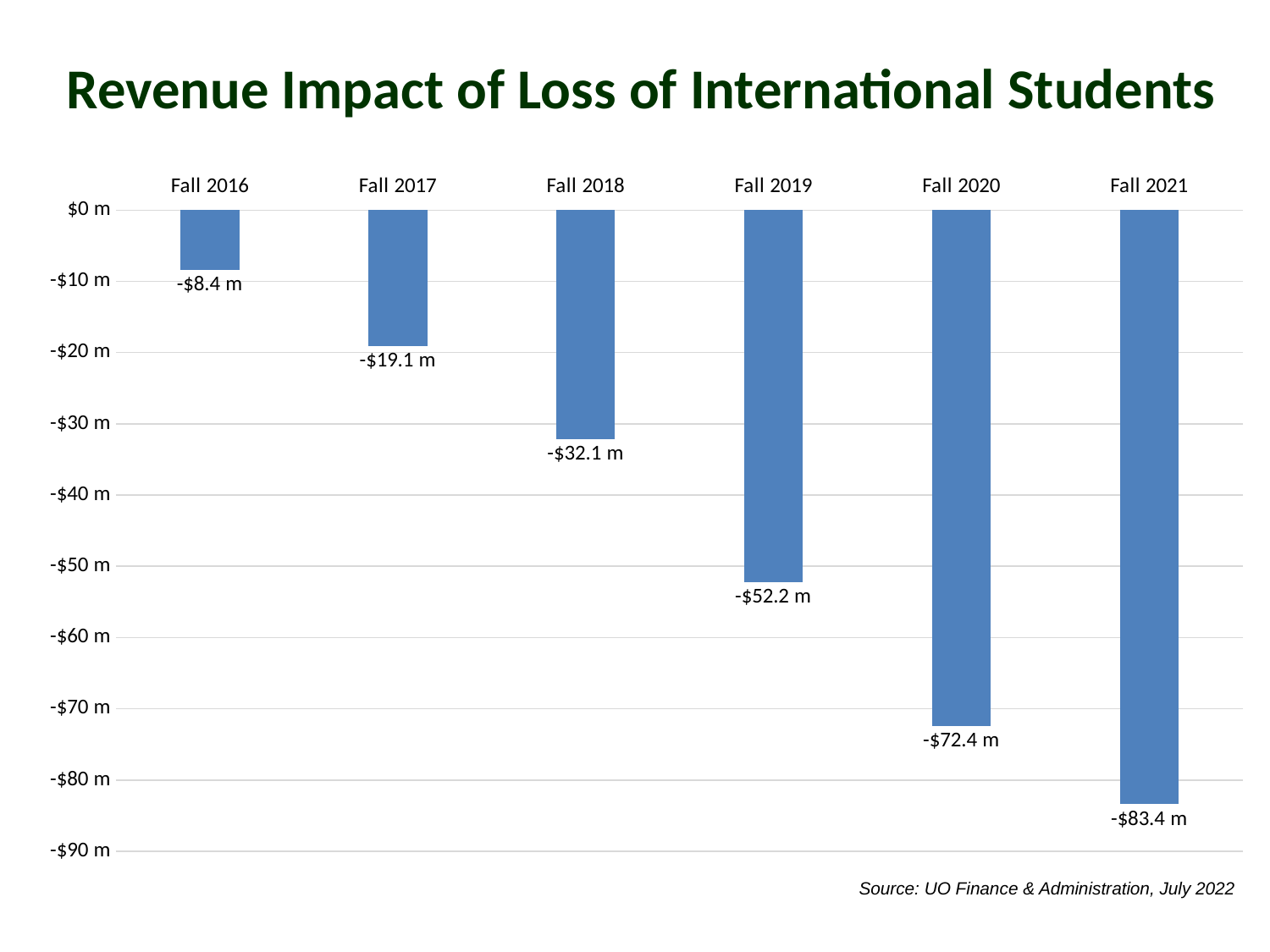
What is the revenue impact shown for Fall 2019? -$52.2 m How many terms are plotted on the chart? 6 Which term shows the largest revenue loss? Fall 2021 What is the revenue impact shown for Fall 2016? -$8.4 m What is the title of the chart? Revenue Impact of Loss of International Students Which term has a larger revenue loss, Fall 2017 or Fall 2018? Fall 2018 What is the revenue impact shown for Fall 2021? -$83.4 m Do the revenue losses grow or shrink from Fall 2016 to Fall 2021? Grow What is the difference between the Fall 2020 and Fall 2019 values? $20.2 m Which term shows the smallest revenue loss? Fall 2016 What source is cited for the chart data? UO Finance & Administration, July 2022 What kind of chart is shown on the slide? Bar chart